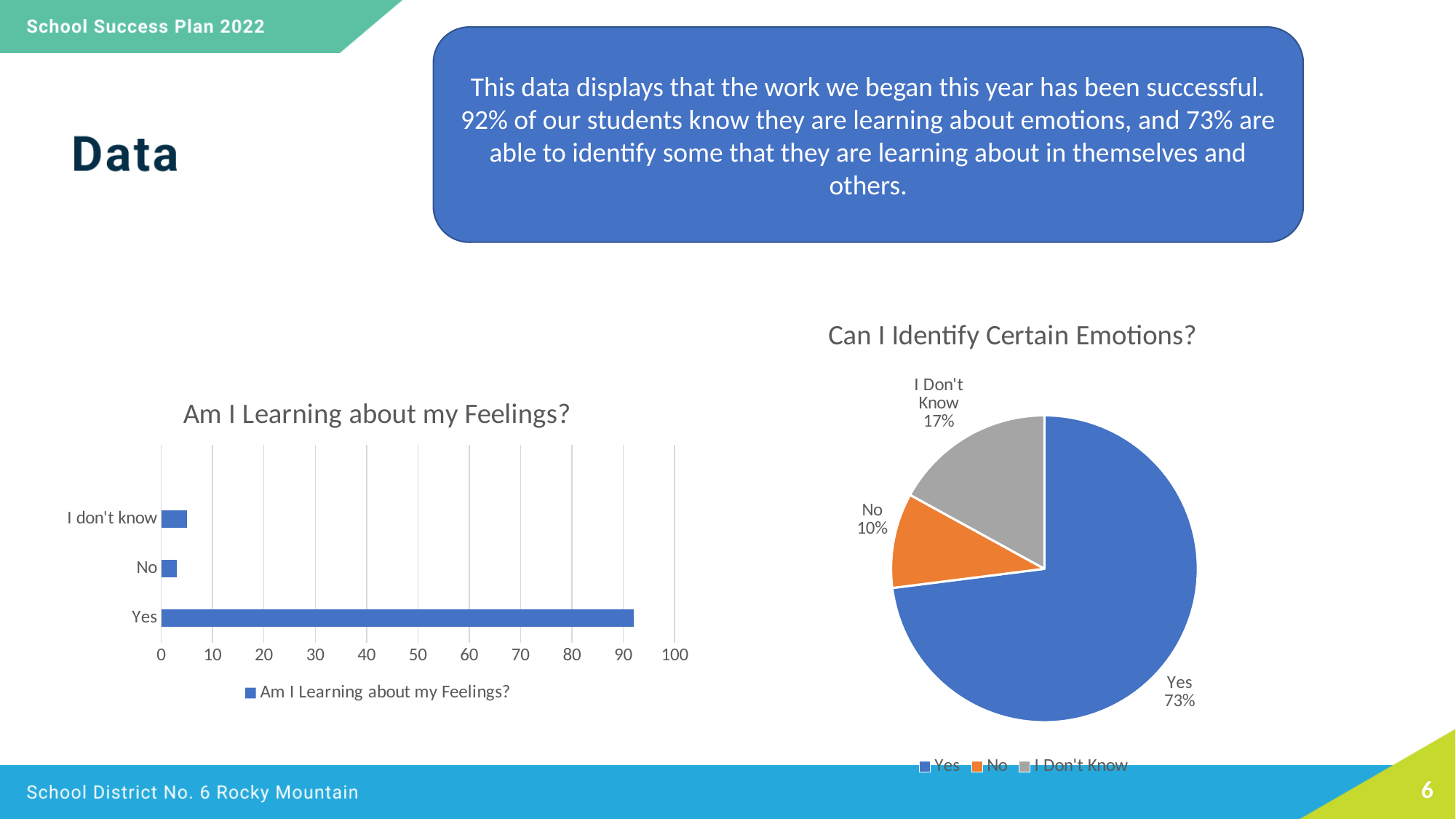
In the 'Can I Identify Certain Emotions?' pie chart, which slice is the smallest? No In the 'Am I Learning about my Feelings?' bar chart, which category has the highest value? Yes In the 'Can I Identify Certain Emotions?' pie chart, how many entries does the legend list? 3 In the 'Am I Learning about my Feelings?' bar chart, how many categories are shown? 3 In the 'Can I Identify Certain Emotions?' pie chart, which slice is the largest? Yes In the 'Can I Identify Certain Emotions?' pie chart, what share is labelled for No? 10% In the 'Am I Learning about my Feelings?' bar chart, is the value for Yes greater or less than 90? greater In the 'Am I Learning about my Feelings?' bar chart, is the value for No greater or less than 10? less In the 'Am I Learning about my Feelings?' chart, what kind of chart is shown? Bar chart In the 'Can I Identify Certain Emotions?' pie chart, what share is labelled for I Don't Know? 17% In the 'Can I Identify Certain Emotions?' pie chart, what share is labelled for Yes? 73% In the 'Can I Identify Certain Emotions?' pie chart, what is the difference between the Yes share and the I Don't Know share? 56%